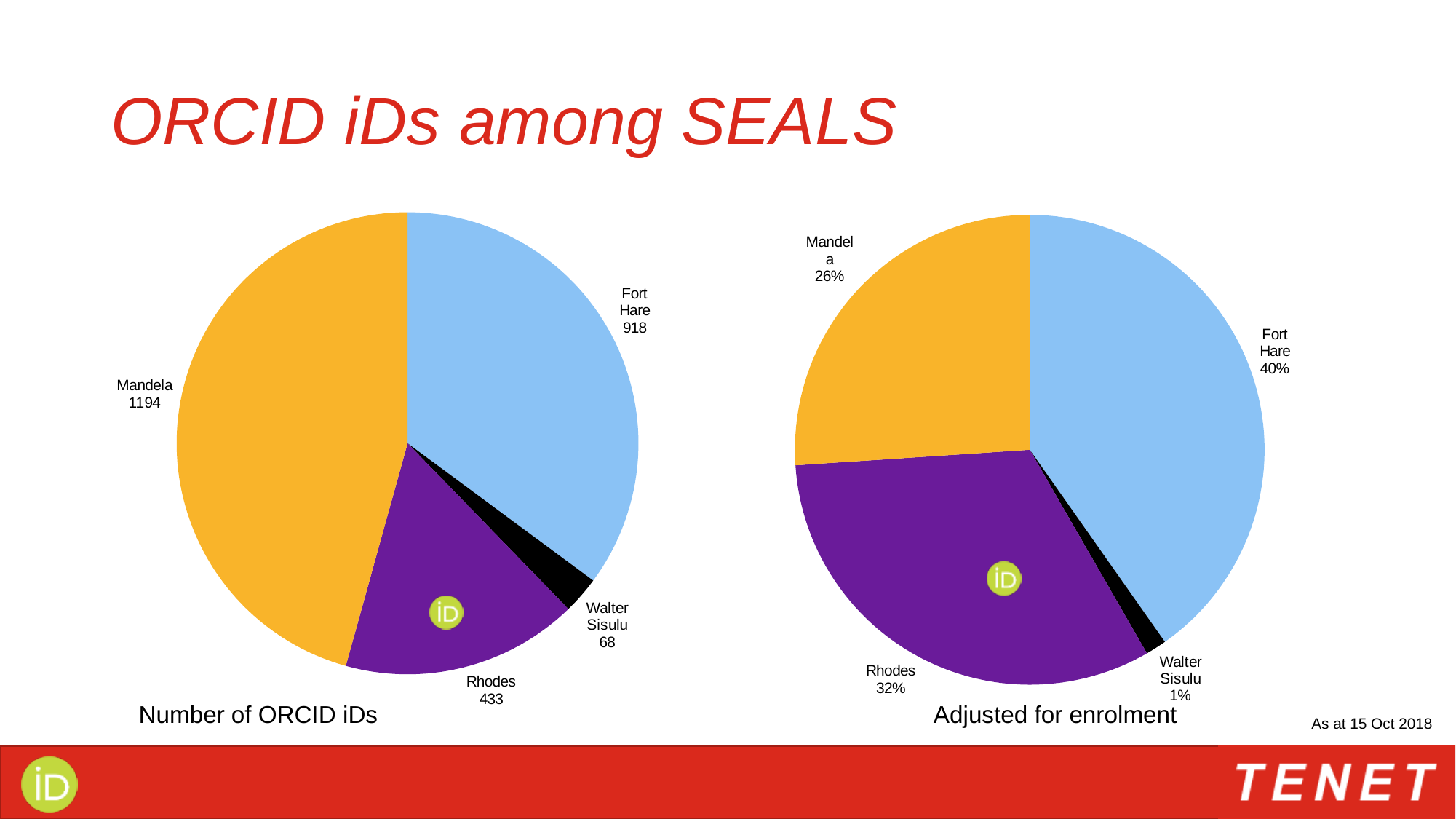
In the 'Number of ORCID iDs' pie chart, what is the difference between Mandela and Fort Hare? 276 What type of chart is the 'Number of ORCID iDs' chart? Pie chart In the 'Number of ORCID iDs' pie chart, what is the value for Walter Sisulu? 68 How many slices does the 'Adjusted for enrolment' pie chart have? 4 In the 'Number of ORCID iDs' pie chart, which is larger, Rhodes or Walter Sisulu? Rhodes In the 'Number of ORCID iDs' pie chart, how many ORCID iDs does Mandela have? 1194 In the 'Number of ORCID iDs' pie chart, what is the value for Fort Hare? 918 In the 'Adjusted for enrolment' pie chart, what share does Fort Hare have? 40% In the 'Adjusted for enrolment' pie chart, which institution has the largest share? Fort Hare In the 'Number of ORCID iDs' pie chart, which institution has the largest slice? Mandela In the 'Number of ORCID iDs' pie chart, which institution has the smallest slice? Walter Sisulu In the 'Adjusted for enrolment' pie chart, what share does Rhodes have? 32%